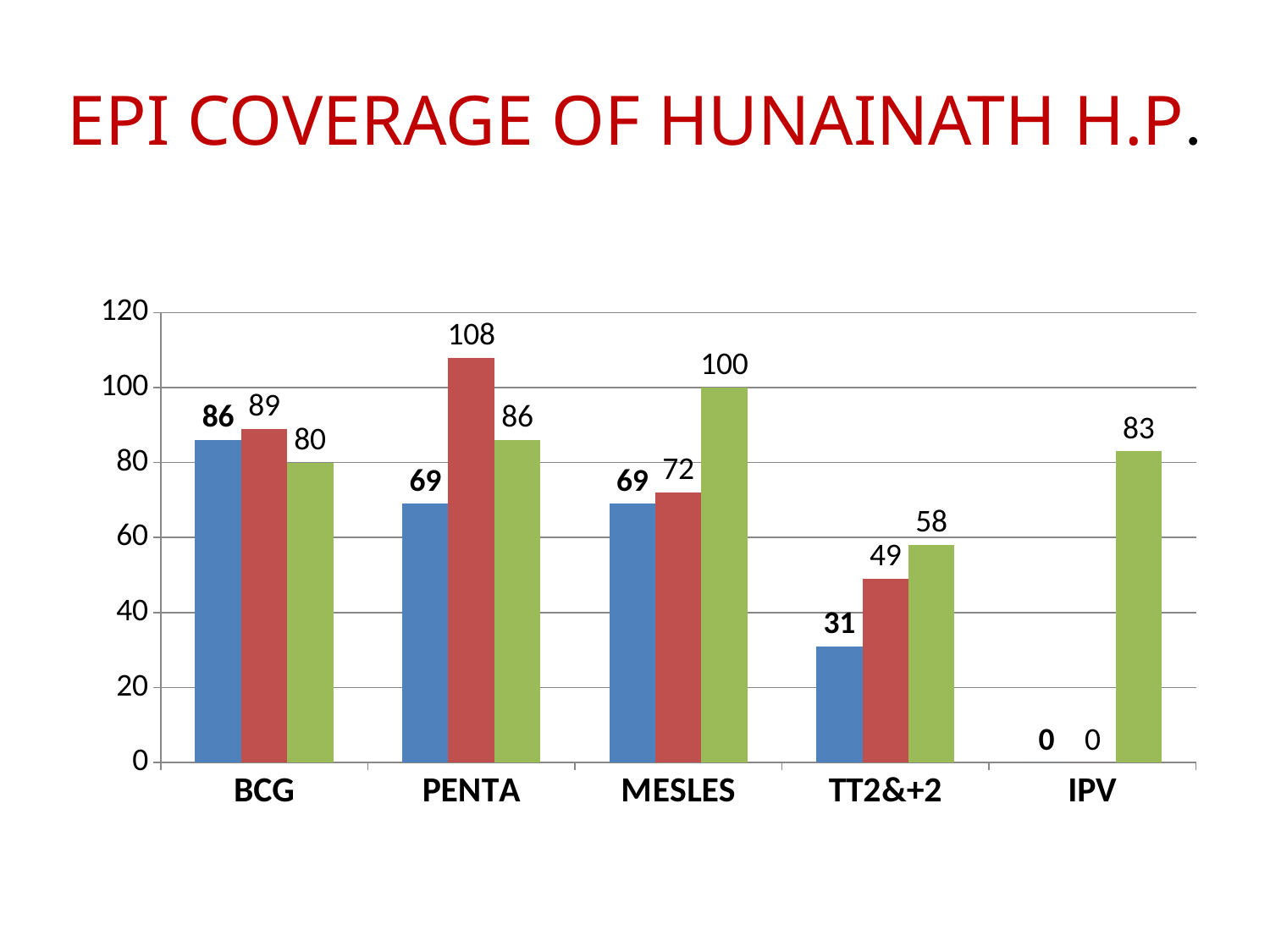
Which is larger for BCG, the red bar or the green bar? the red bar What is the difference between the red and blue bars for PENTA? 39 Which category has the lowest blue bar? IPV What is the value of the red bar for TT2&+2? 49 What is the difference between the green bars for MESLES and TT2&+2? 42 What kind of chart is shown on the slide? bar chart What is the value of the red bar for PENTA? 108 What is the value of the blue bar for BCG? 86 Which category has the highest green bar? MESLES What is the value of the green bar for IPV? 83 How many categories are shown on the x axis? 5 What is the title of the slide? EPI COVERAGE OF HUNAINATH H.P.